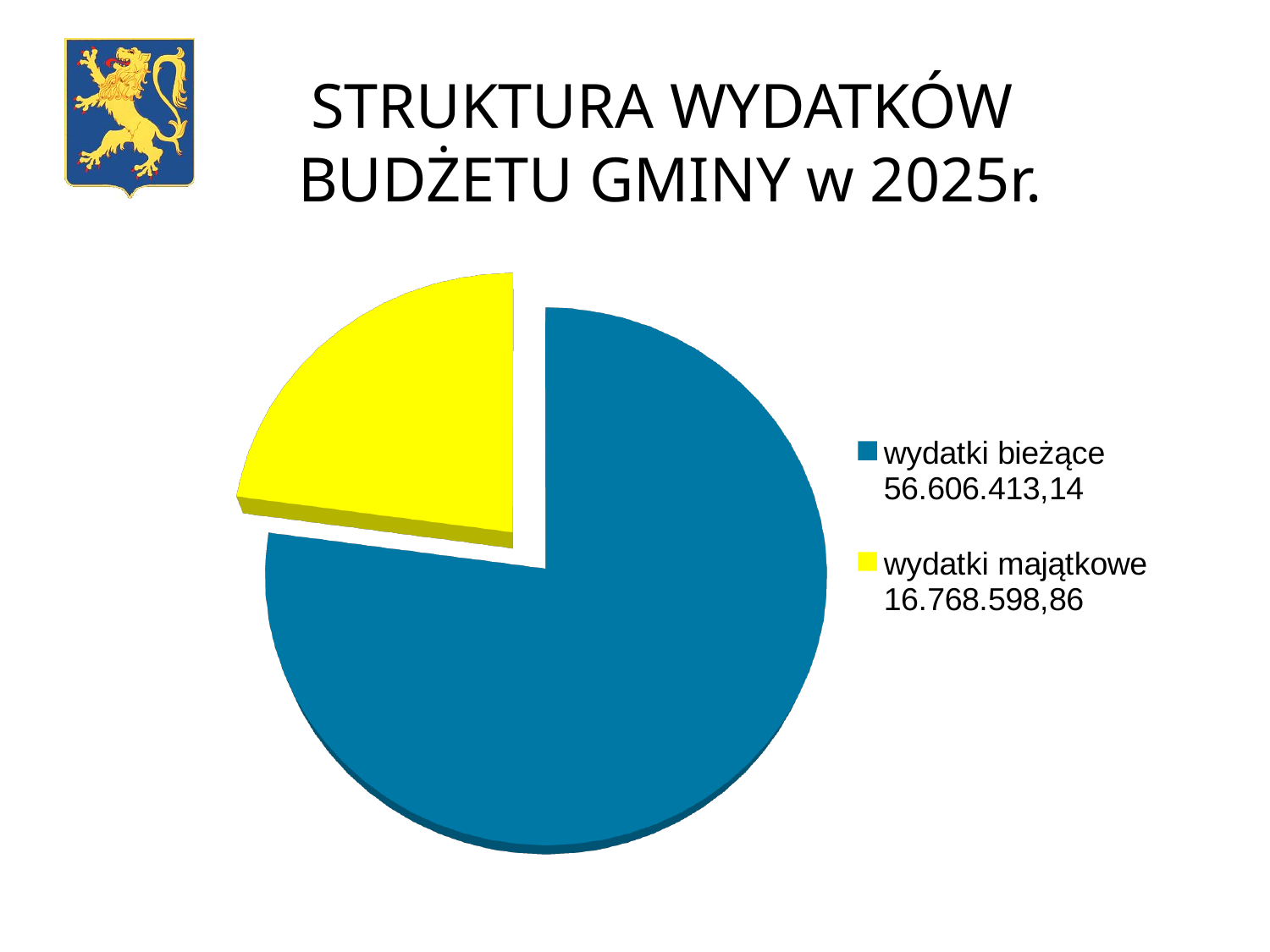
What kind of chart is shown on the slide? pie chart What is the value for wydatki majątkowe? 16.768.598,86 What is the total of wydatki bieżące and wydatki majątkowe? 73.375.012,00 What is the title of the slide? STRUKTURA WYDATKÓW BUDŻETU GMINY w 2025r. What is the difference between wydatki bieżące and wydatki majątkowe? 39.837.814,28 How many entries does the legend list? 2 Which is larger, wydatki bieżące or wydatki majątkowe? wydatki bieżące What colour is the slice for wydatki majątkowe? yellow What is the value for wydatki bieżące? 56.606.413,14 How many slices does the pie chart have? 2 Which category has the largest value? wydatki bieżące Which category has the smallest value? wydatki majątkowe